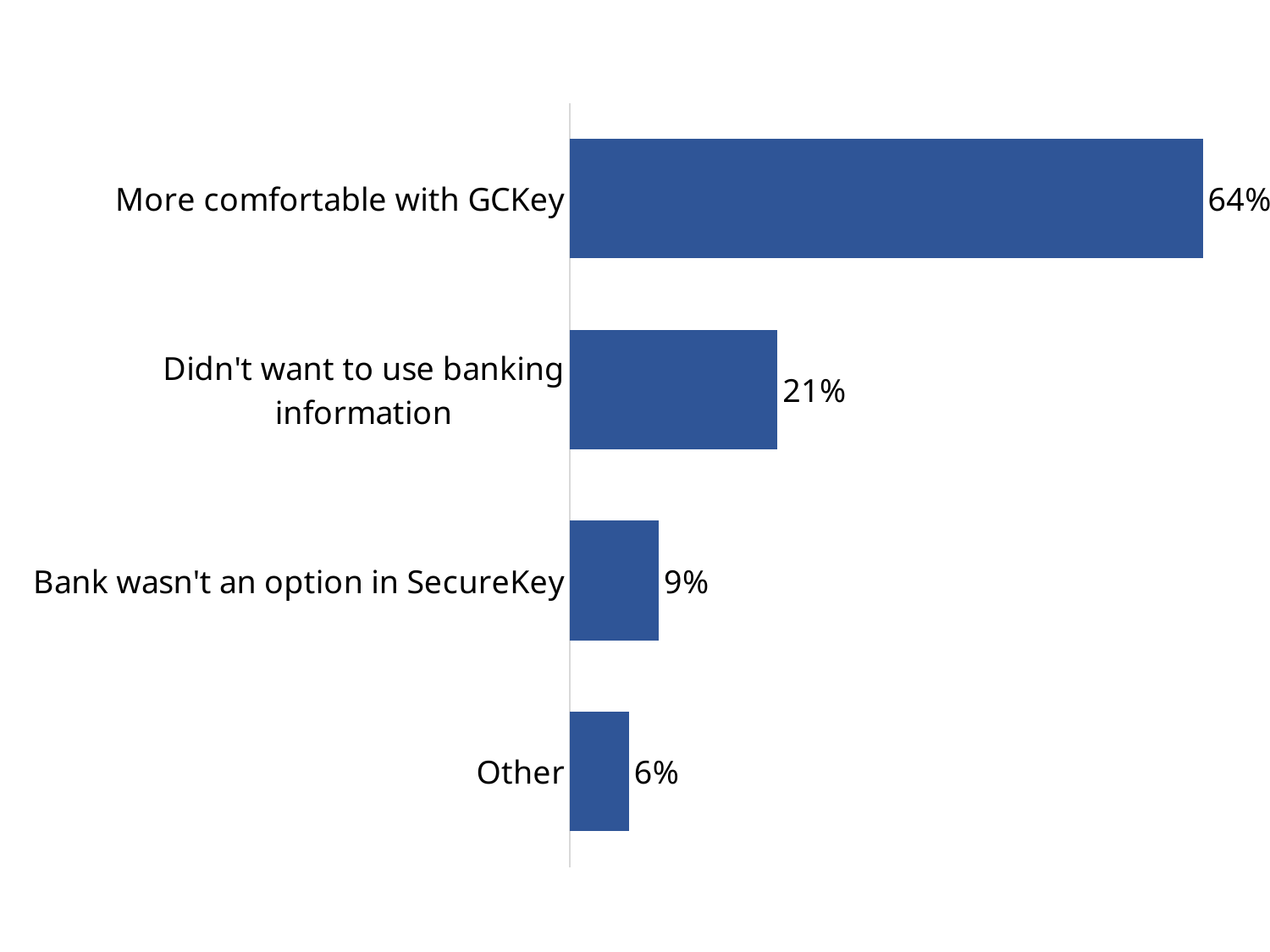
What is the value for "More comfortable with GCKey"? 64% What is the value for "Didn't want to use banking information"? 21% Which category has the highest value? More comfortable with GCKey What is the value for "Other"? 6% What is the value for "Bank wasn't an option in SecureKey"? 9% Which is larger: the value for "Didn't want to use banking information" or the value for "Bank wasn't an option in SecureKey"? Didn't want to use banking information What colour are the bars in the chart? Blue How many categories are shown in the chart? 4 What is the difference between the values for "Bank wasn't an option in SecureKey" and "Other"? 3% What is the difference between the values for "More comfortable with GCKey" and "Didn't want to use banking information"? 43% What kind of chart is shown on the slide? Bar chart Which category has the lowest value? Other